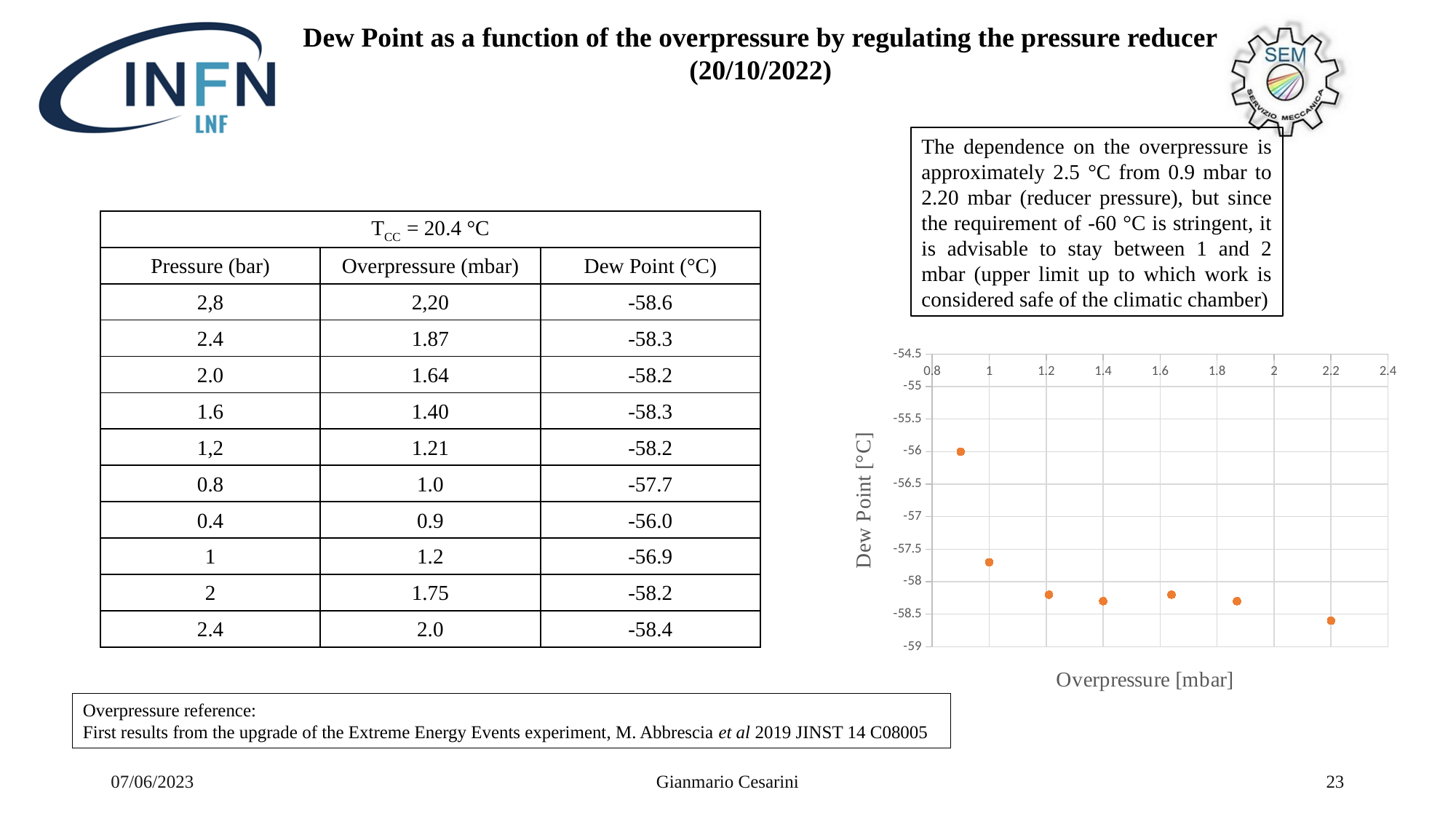
What is the label of the vertical axis of the chart? Dew Point [°C] Which point has the lowest dew point in the chart: the one near 1.4 mbar or the one near 2.2 mbar? the one near 2.2 mbar What kind of chart is shown on the slide? scatter chart Which plotted point has the highest dew point: the leftmost point or the rightmost point? the leftmost point Is the dew point of the rightmost point (near 2.2 mbar) greater or less than -58? less Does the dew point generally rise or fall as the overpressure increases along the x axis? fall Is the dew point of the leftmost point (near 0.9 mbar) greater or less than -57? greater What is the label of the horizontal axis of the chart? Overpressure [mbar] How many data points are plotted in the chart? 7 Is the dew point of the point at about 1.2 mbar greater or less than -58? less